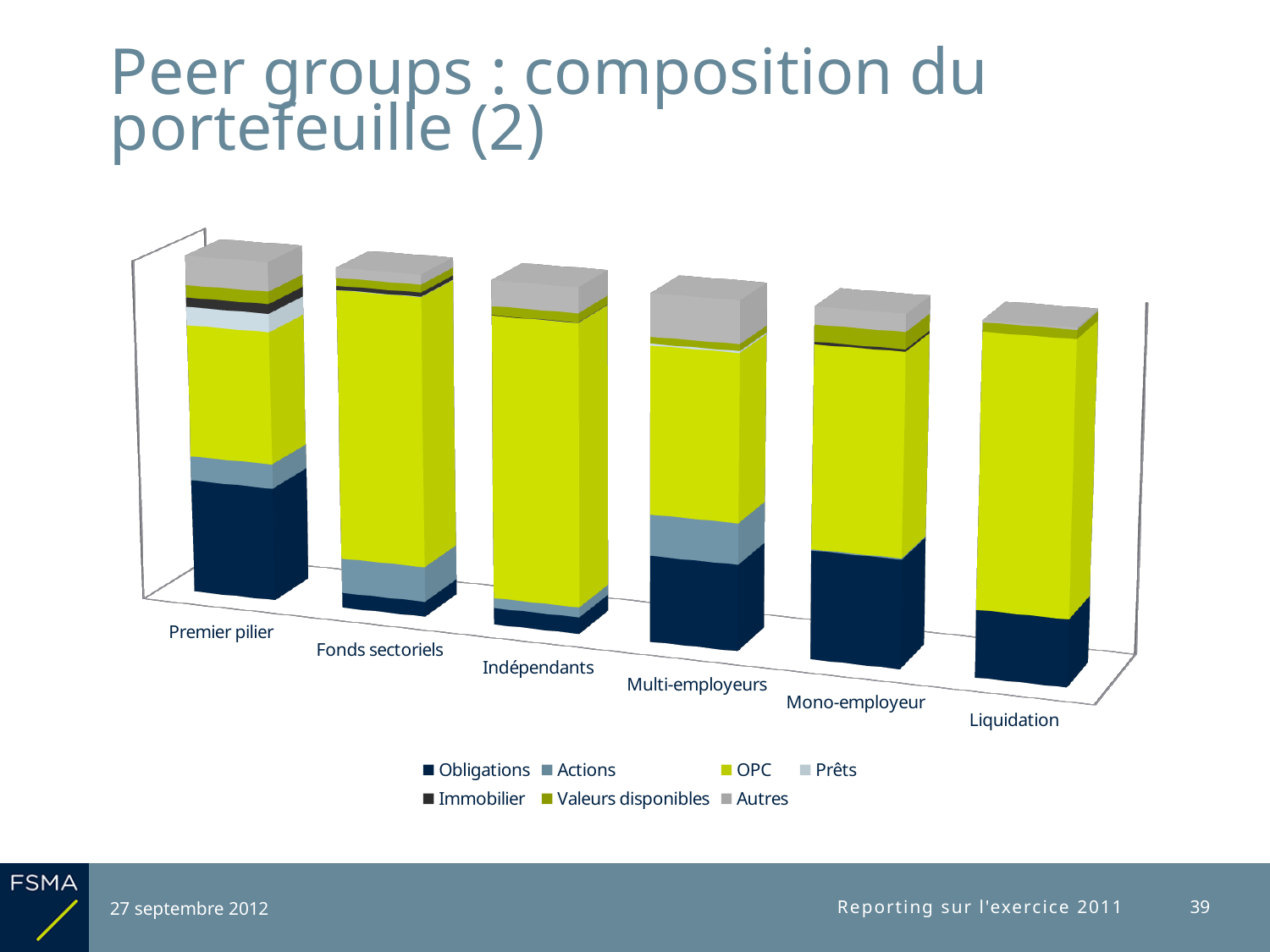
Which series makes up the largest segment of the Fonds sectoriels bar? OPC How many series does the chart legend list? 7 Which series makes up the largest segment of the Liquidation bar? OPC What kind of chart is shown on the slide? Stacked bar chart Is the Prêts segment larger for Premier pilier or for Liquidation? Premier pilier Is the Obligations segment larger for Multi-employeurs or for Fonds sectoriels? Multi-employeurs What is the label of the first category on the left of the x axis? Premier pilier What is the title of the slide containing the chart? Peer groups : composition du portefeuille (2) How many peer group categories are shown along the x axis of the chart? 6 Is the OPC segment larger for Liquidation or for Premier pilier? Liquidation Which series is shown in yellow-green in the chart legend? OPC